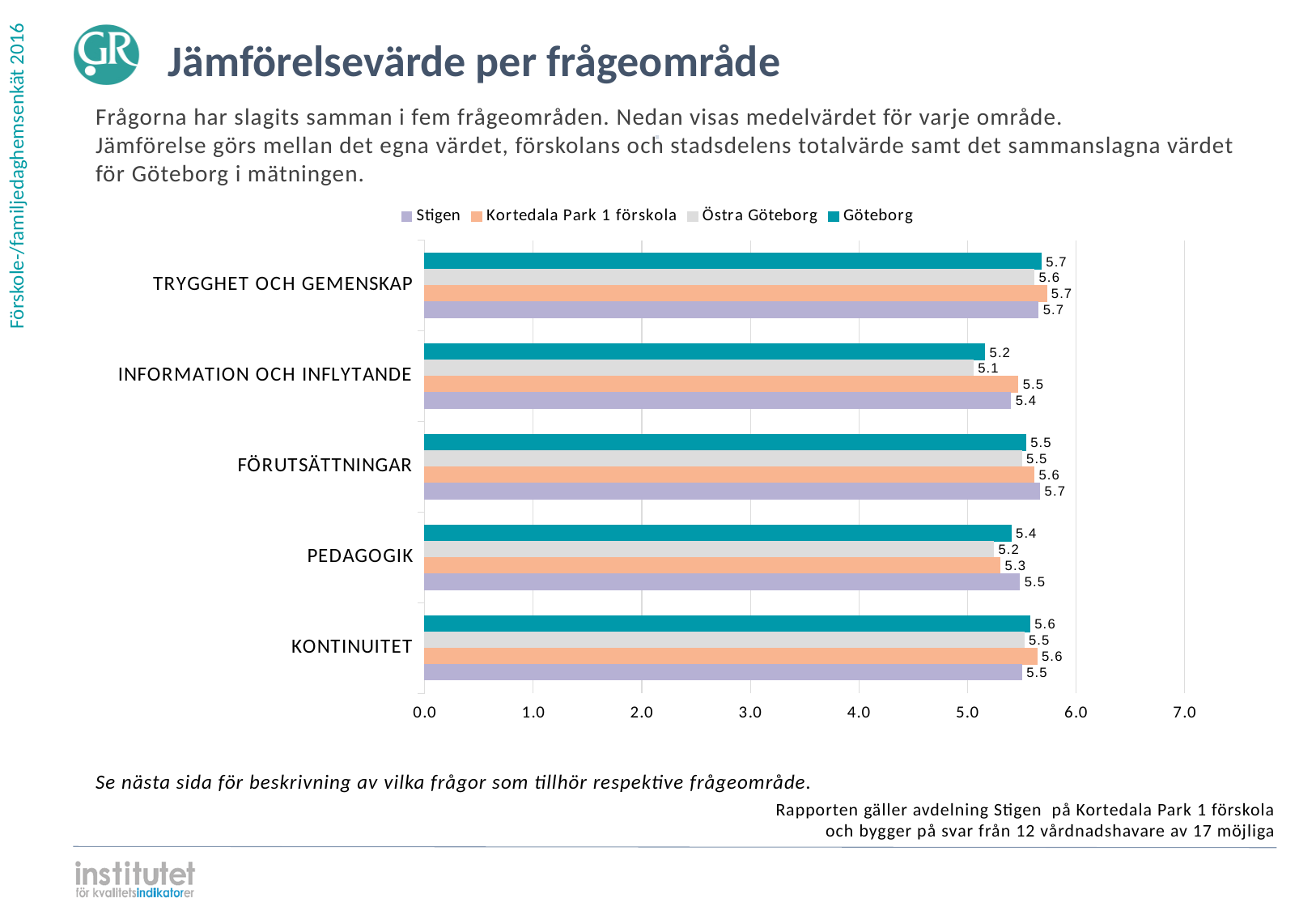
In which category does Östra Göteborg have its lowest value? INFORMATION OCH INFLYTANDE What is the difference between the Kortedala Park 1 förskola value and the Östra Göteborg value in the INFORMATION OCH INFLYTANDE category? 0.4 What is the value for Kortedala Park 1 förskola in the FÖRUTSÄTTNINGAR category? 5.6 In the PEDAGOGIK category, which is larger: the value for Stigen or the value for Östra Göteborg? Stigen What is the title of the slide? Jämförelsevärde per frågeområde What is the value for Göteborg in the PEDAGOGIK category? 5.4 How many categories are shown on the chart? 5 How many series does the legend list? 4 In which category does Stigen have its lowest value? INFORMATION OCH INFLYTANDE What is the value for Stigen in the INFORMATION OCH INFLYTANDE category? 5.4 What kind of chart is shown on the slide? Bar chart What is the value for Östra Göteborg in the KONTINUITET category? 5.5